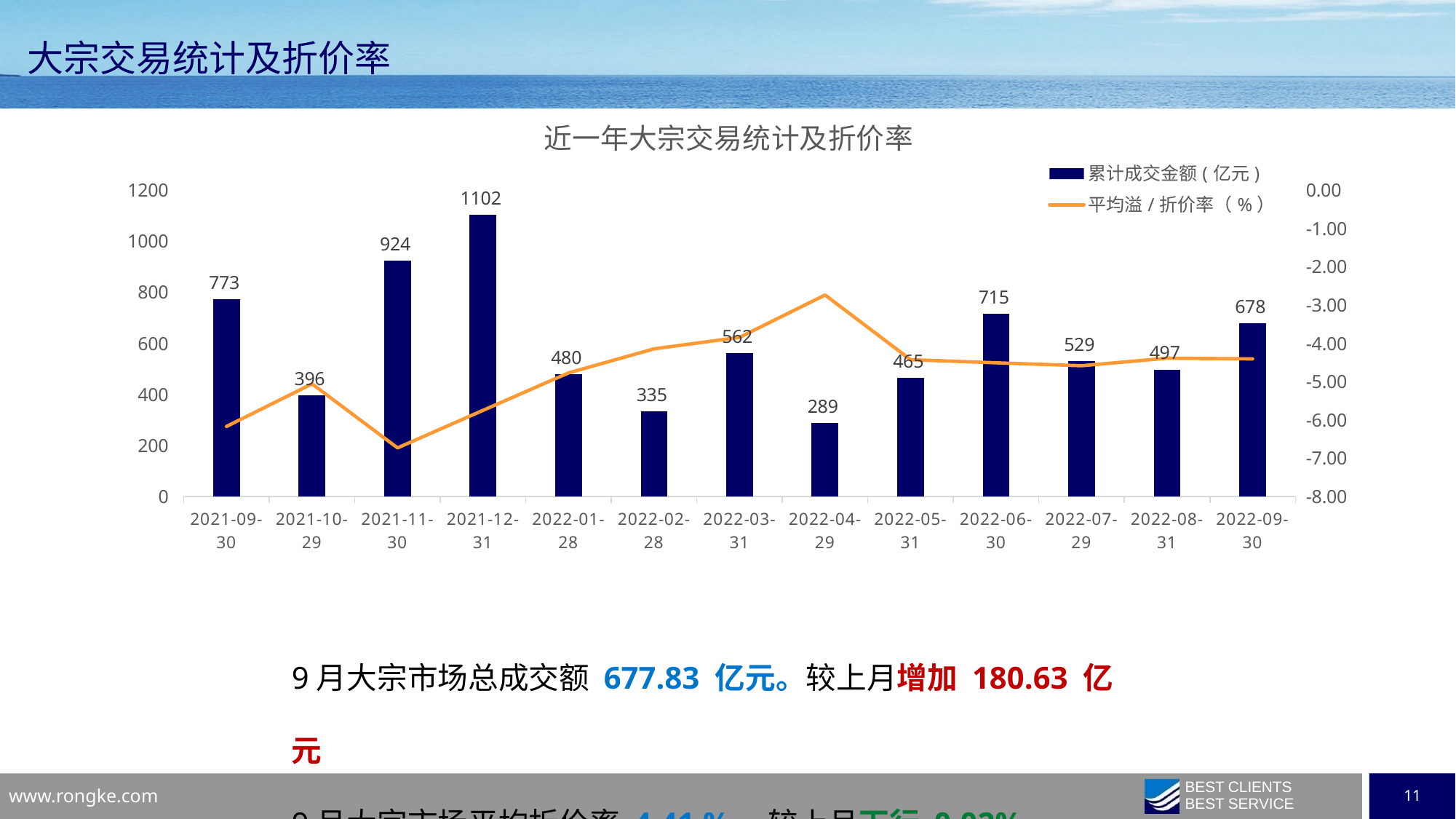
Is the 平均溢/折价率 value for 2021-11-30 greater or less than -6.00? less How many series does the legend list? 2 What is the 累计成交金额 value for 2021-12-31? 1102 How many dates are shown on the x axis of the chart? 13 What is the difference in 累计成交金额 between 2022-09-30 and 2022-08-31? 181 Which date has the highest 累计成交金额? 2021-12-31 Which date has the lowest 累计成交金额? 2022-04-29 Is the 平均溢/折价率 value for 2022-04-29 greater or less than -4.00? greater What is the 累计成交金额 value for 2022-04-29? 289 What is the title of the chart? 近一年大宗交易统计及折价率 What is the 累计成交金额 value for 2022-09-30? 678 Which has a larger 累计成交金额, 2021-11-30 or 2022-06-30? 2021-11-30